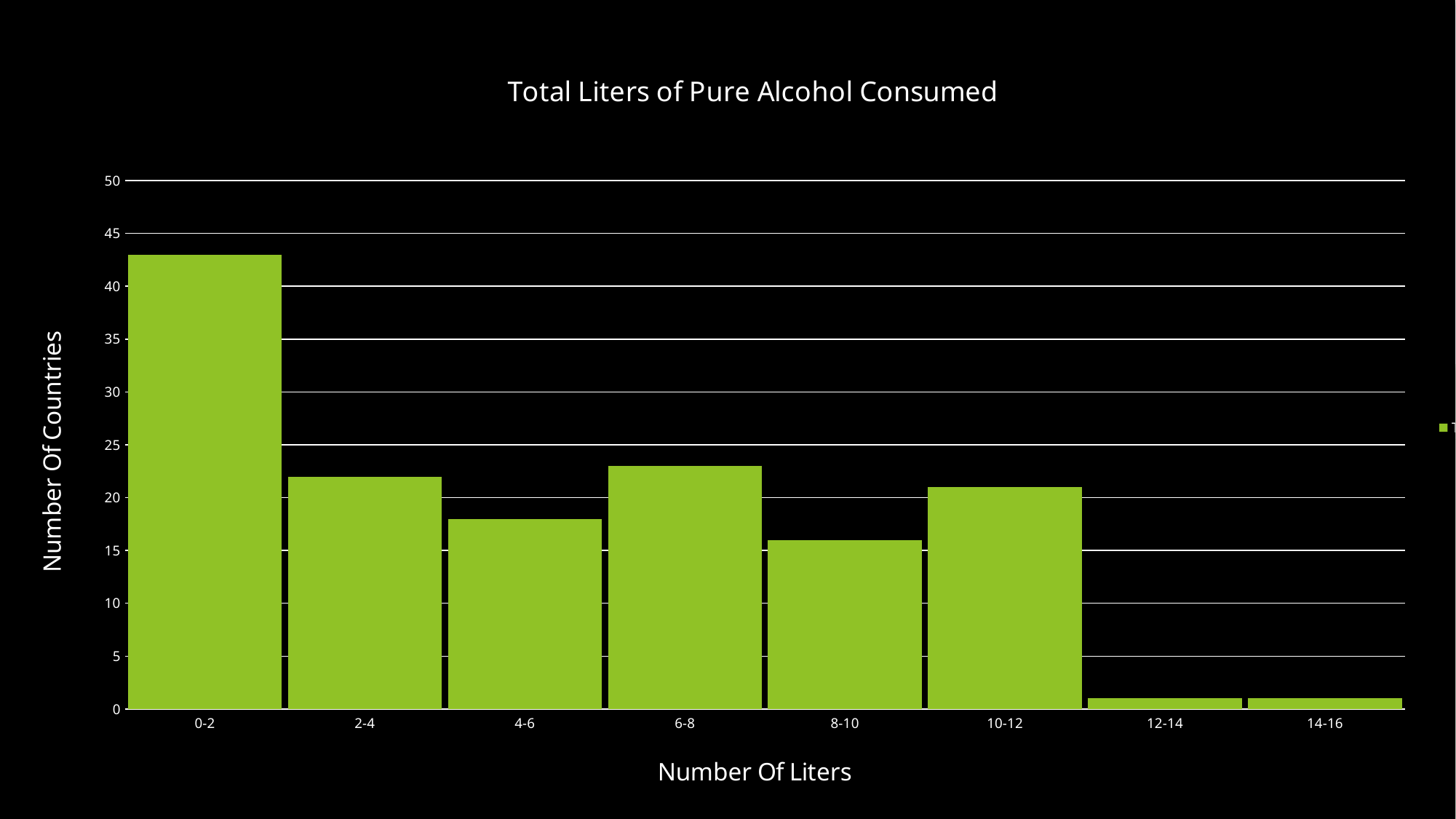
Is the number of countries for the 4-6 range greater or less than 20? less Which has more countries, the 10-12 range or the 8-10 range? 10-12 What is the label on the vertical axis of the chart? Number Of Countries How many liter ranges (categories) are shown on the x axis? 8 Which has more countries, the 0-2 range or the 2-4 range? 0-2 Is the number of countries for the 6-8 range greater or less than 20? greater What kind of chart is shown on the slide? bar chart What is the title of the chart? Total Liters of Pure Alcohol Consumed Is the number of countries for the 8-10 range greater or less than 15? greater Which liter range has the highest number of countries? 0-2